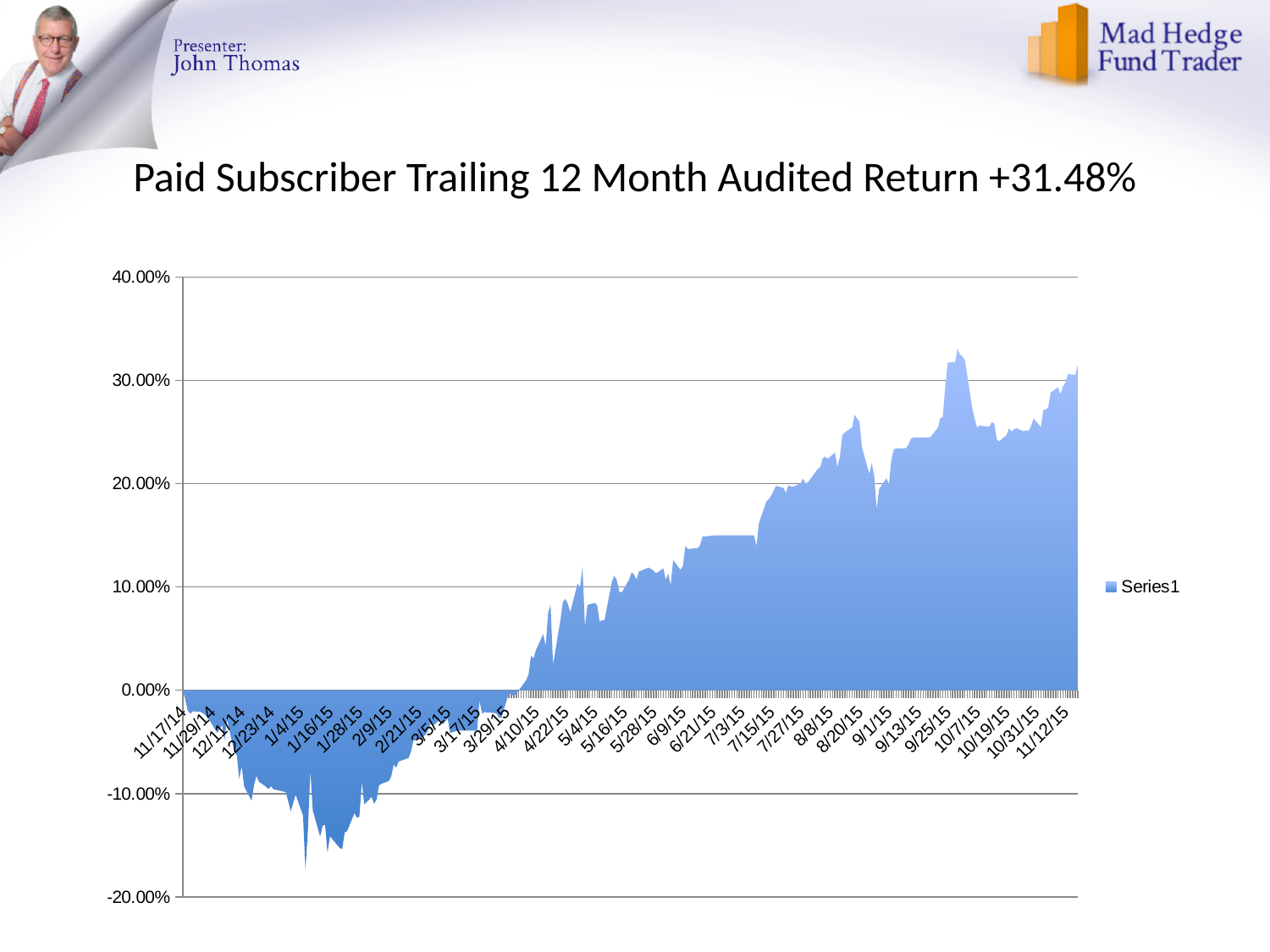
Is the value at 7/3/15 greater or less than 10.00%? greater What is the title of the slide above the chart? Paid Subscriber Trailing 12 Month Audited Return +31.48% What kind of chart is shown on the slide? Area chart Is the value around 1/16/15 greater or less than -10.00%? less Which date has the larger value, 8/8/15 or 5/4/15? 8/8/15 How many series does the legend list? 1 What is the legend entry shown on the chart? Series1 Overall, do the values rise or fall from the left of the x axis (11/17/14) to the right (11/12/15)? Rise Which date has the larger value, 11/12/15 or 1/16/15? 11/12/15 Is the value at 5/16/15 greater or less than 20.00%? less